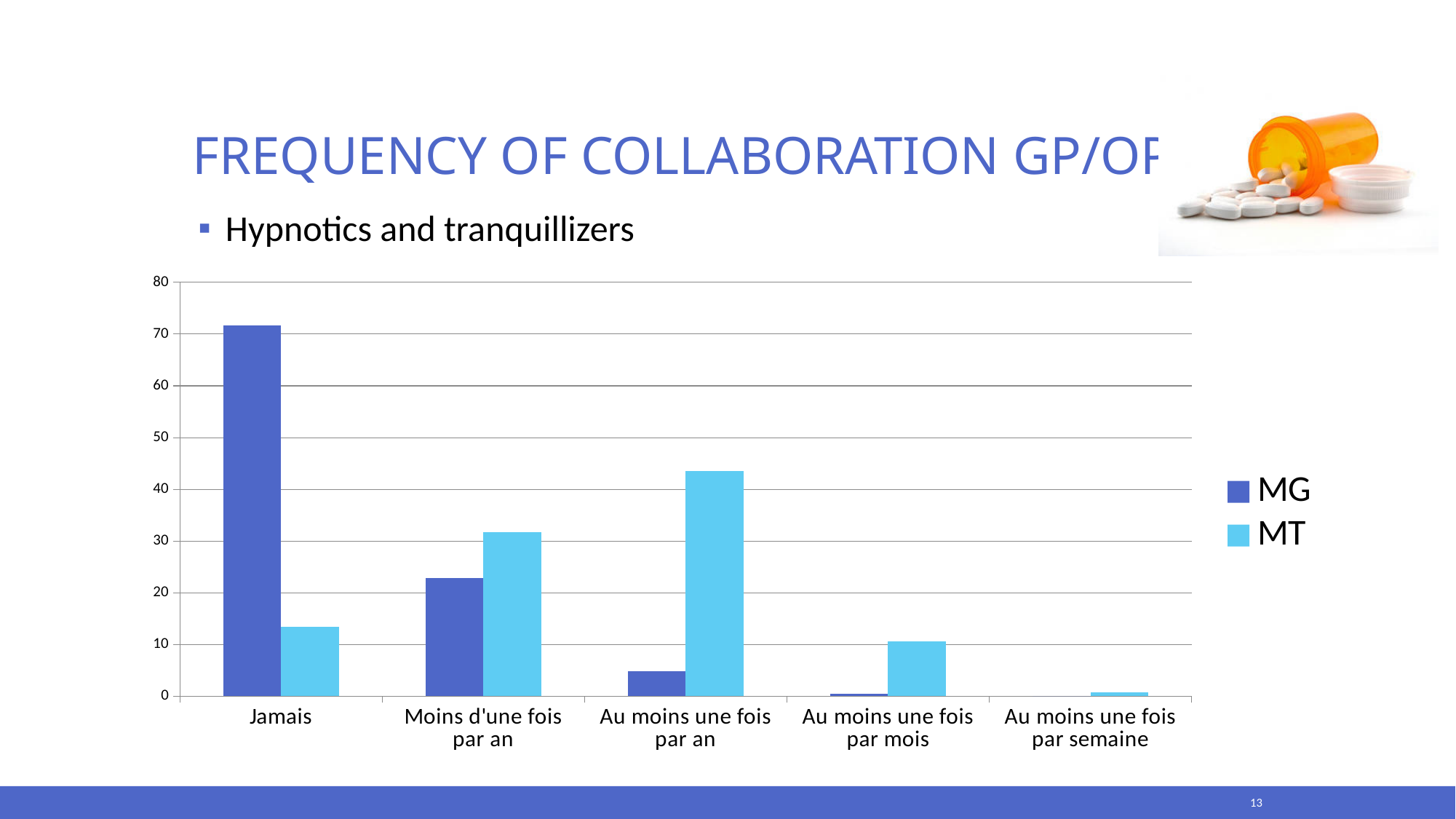
What are the two series names listed in the chart legend? MG and MT For the category Jamais, which series has the larger value, MG or MT? MG Which category has the lowest value for the MT series? Au moins une fois par semaine Is the MG value for Moins d'une fois par an greater or less than 30? less Which category has the highest value for the MG series? Jamais Is the MG value for Jamais greater or less than 60? greater How many categories are shown on the x axis of the chart? 5 For the category Au moins une fois par an, which series has the larger value, MG or MT? MT What type of chart is shown on the slide? bar chart How many series does the chart legend list? 2 Which category has the highest value for the MT series? Au moins une fois par an Is the MT value for Au moins une fois par an greater or less than 40? greater